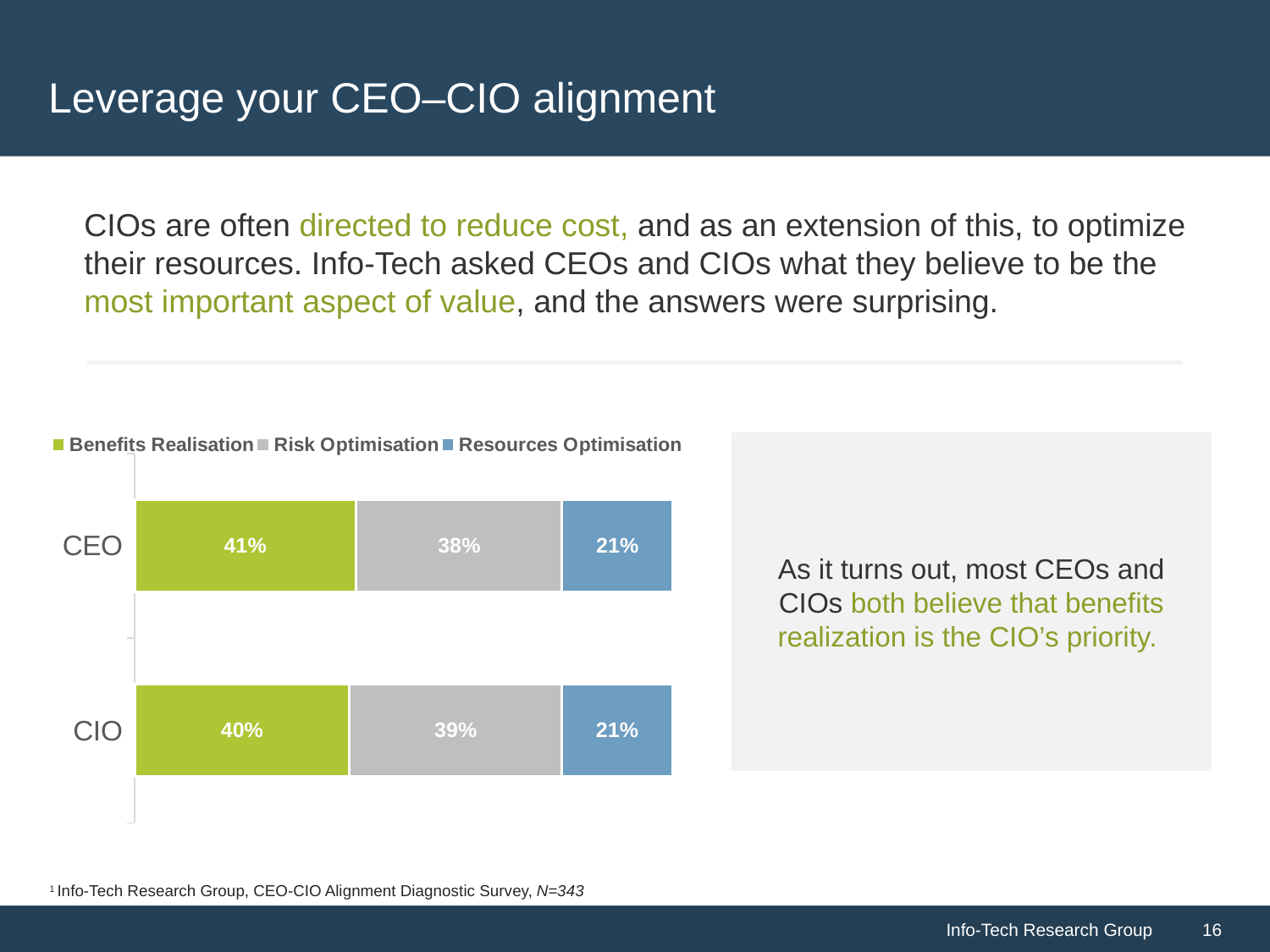
How many respondent groups (categories) are shown on the chart? 2 What percentage of CIOs chose Risk Optimisation? 39% Which is larger: the CEO share for Benefits Realisation or the CEO share for Risk Optimisation? Benefits Realisation What kind of chart is shown on the slide? Stacked bar chart Which aspect of value received the lowest share among CIOs? Resources Optimisation How many series does the legend list? 3 What is the difference between the CEO and CIO percentages for Risk Optimisation? 1% Which series is shown in blue in the legend? Resources Optimisation What percentage of CIOs chose Resources Optimisation? 21% What percentage of CEOs chose Benefits Realisation? 41% Which aspect of value received the highest share among CEOs? Benefits Realisation What is the total of the CIO stacked bar? 100%